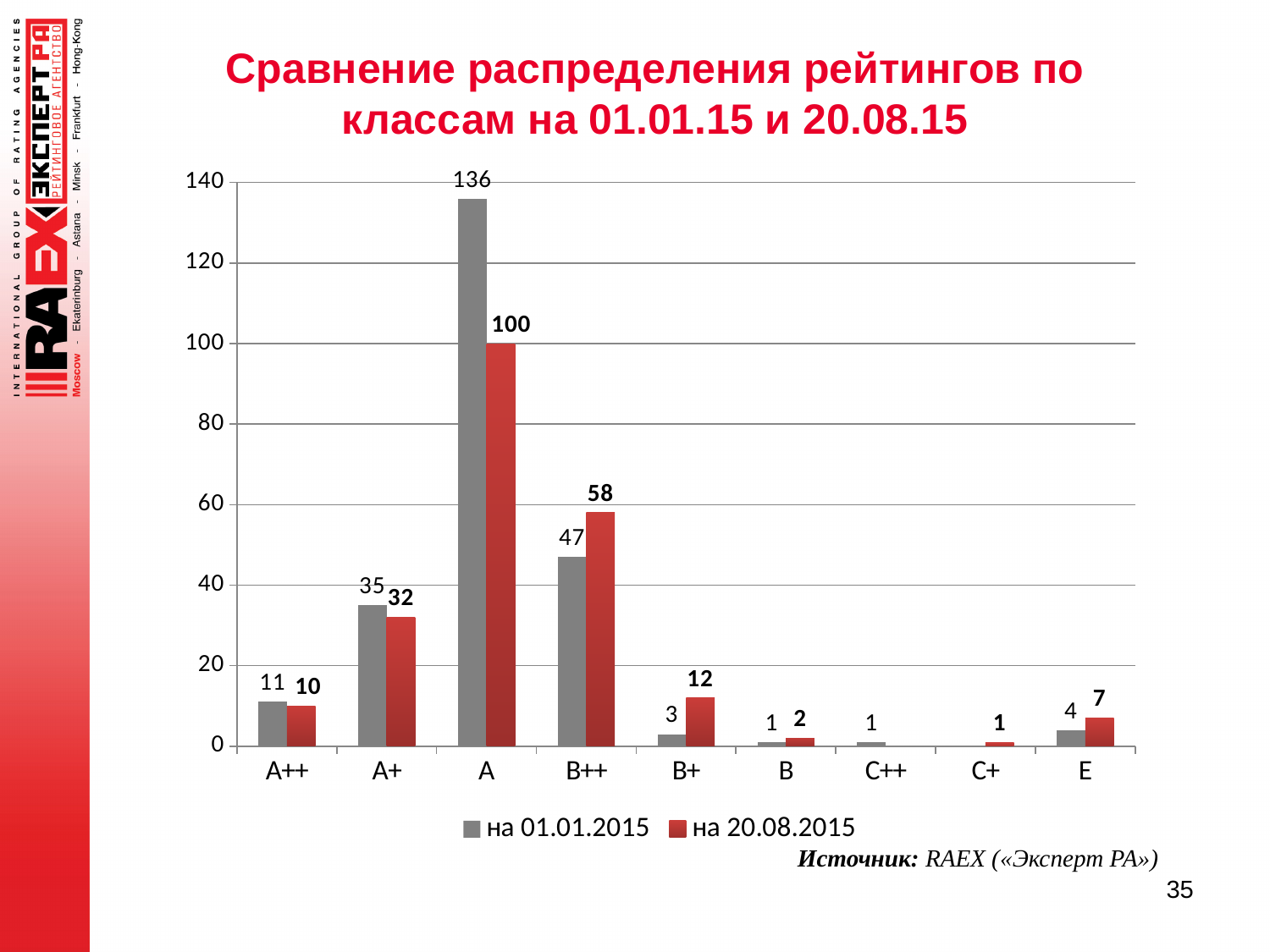
What kind of chart is shown on the slide? bar chart What is the value for class E in the series "на 01.01.2015"? 4 What is the difference between the two series' values for class B+? 9 What is the value for class A in the series "на 01.01.2015"? 136 How many series does the legend list? 2 Which class has the highest value in the series "на 20.08.2015"? A What is the value for class C+ in the series "на 20.08.2015"? 1 How many rating classes are shown on the x axis? 9 What colour are the bars for the series "на 20.08.2015"? red What is the value for class B++ in the series "на 20.08.2015"? 58 What is the difference between the two series' values for class A? 36 For class A+, which series has the larger value, "на 01.01.2015" or "на 20.08.2015"? на 01.01.2015